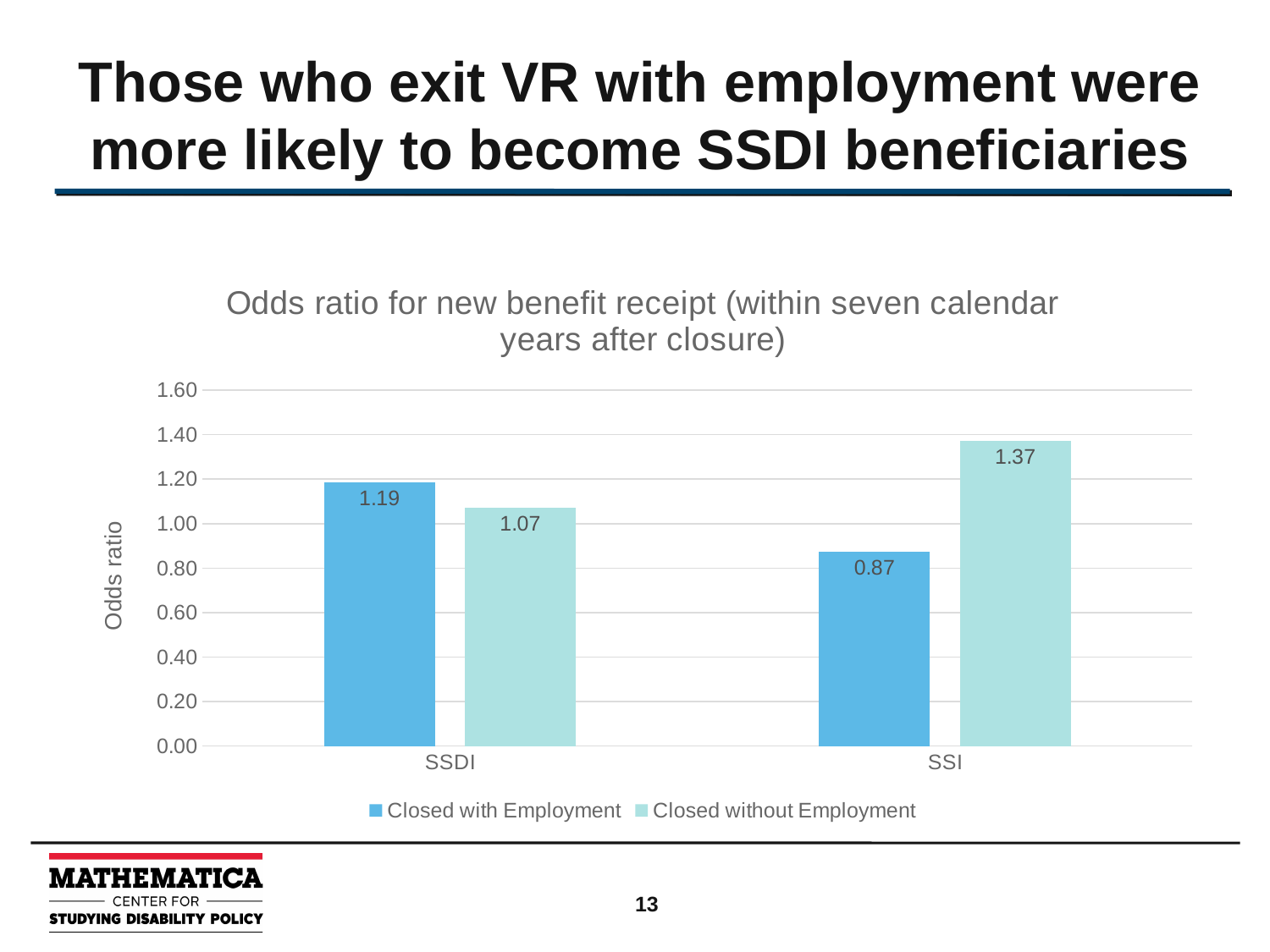
What is the difference between the Closed with Employment and Closed without Employment odds ratios for SSDI? 0.12 Which bar has the lowest odds ratio on the chart? SSI, Closed with Employment What is the difference between the Closed without Employment and Closed with Employment odds ratios for SSI? 0.50 What is the odds ratio for SSI for Closed without Employment? 1.37 What is the odds ratio for SSI for Closed with Employment? 0.87 For SSDI, which series has the larger odds ratio: Closed with Employment or Closed without Employment? Closed with Employment What type of chart is shown on the slide? Bar chart What is the odds ratio for SSDI for Closed with Employment? 1.19 Which bar has the highest odds ratio on the chart? SSI, Closed without Employment How many series does the legend list? 2 How many categories are shown on the x axis? 2 What is the odds ratio for SSDI for Closed without Employment? 1.07